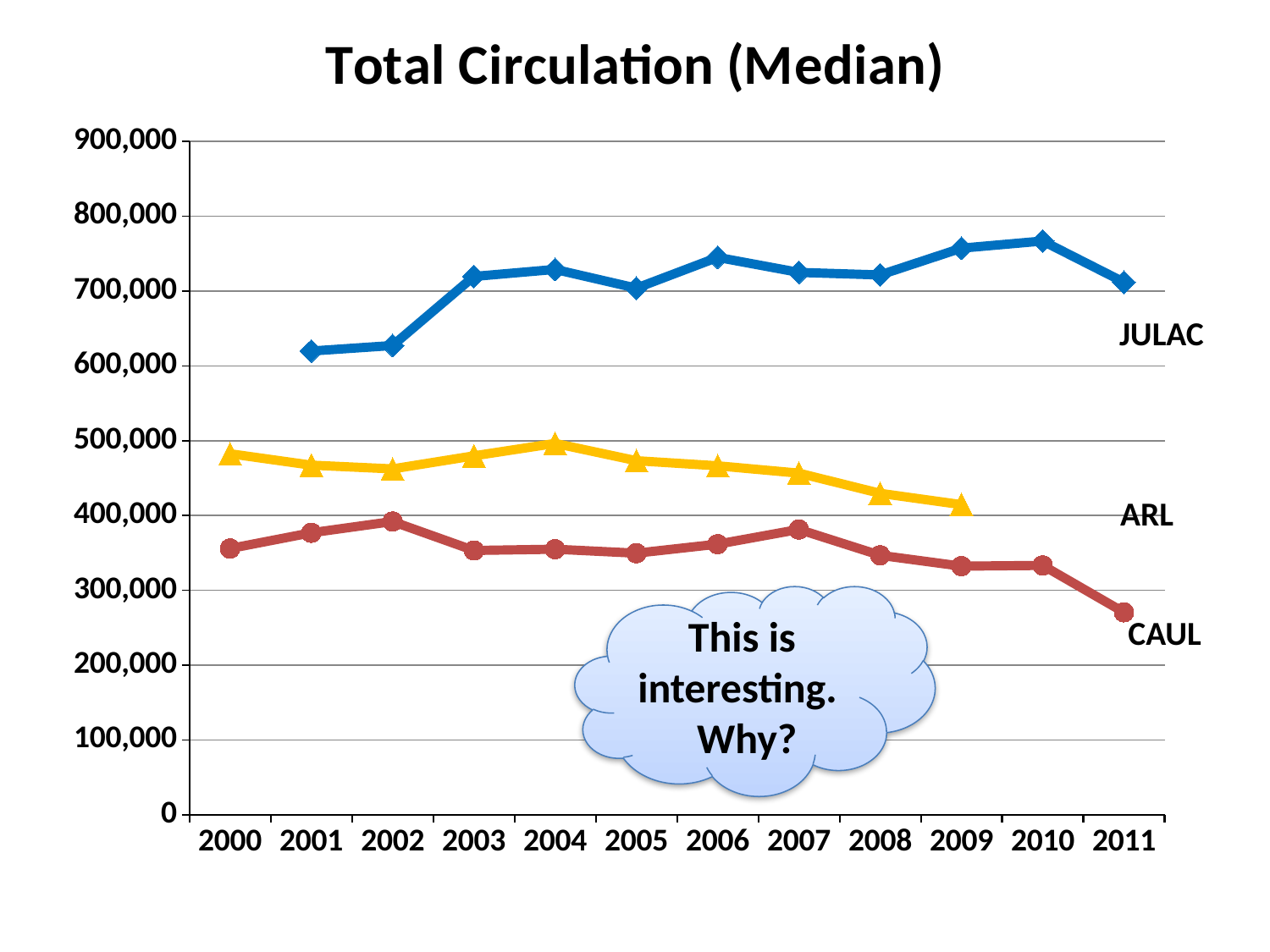
How many series are plotted on the chart? 3 Is the value for JULAC in 2010 greater or less than 700,000? greater In which year does the ARL series reach its lowest value? 2009 Do the ARL values rise or fall from 2004 to 2009? fall How many years are shown on the x axis? 12 Which is larger in 2005, the value for JULAC or the value for ARL? JULAC In which year does the CAUL series reach its lowest value? 2011 What is the title of the chart? Total Circulation (Median) Is the value for JULAC in 2001 greater or less than 600,000? greater Is the value for CAUL in 2011 greater or less than 300,000? less What kind of chart is shown on the slide? line chart Which series has the highest values throughout the chart? JULAC